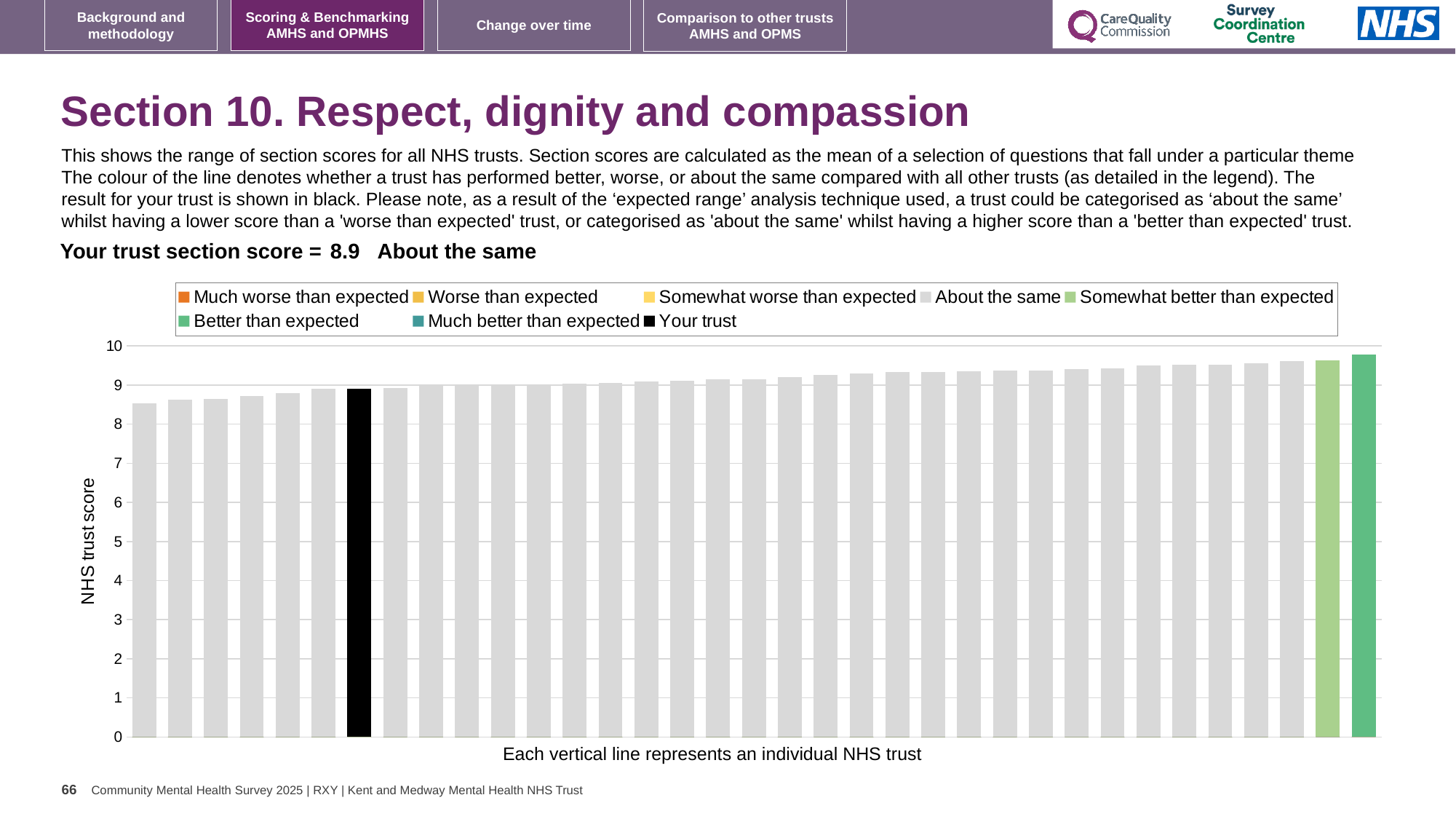
What colour is the bar representing your trust? black Do the bar values rise or fall from left to right across the chart? rise Is the value of the rightmost (highest) bar greater or less than 10? less What is the label on the vertical axis of the chart? NHS trust score Which category is your trust placed in according to the text above the chart? About the same What kind of chart is shown on the slide? bar chart How many entries does the chart legend list? 8 Is the value of the leftmost (lowest) bar greater or less than 8? greater Which legend category does the shortest bar belong to? About the same What is the trust section score printed on the slide? 8.9 Which legend category does the tallest bar belong to? Better than expected Is the value of the black bar (your trust) greater or less than 8? greater